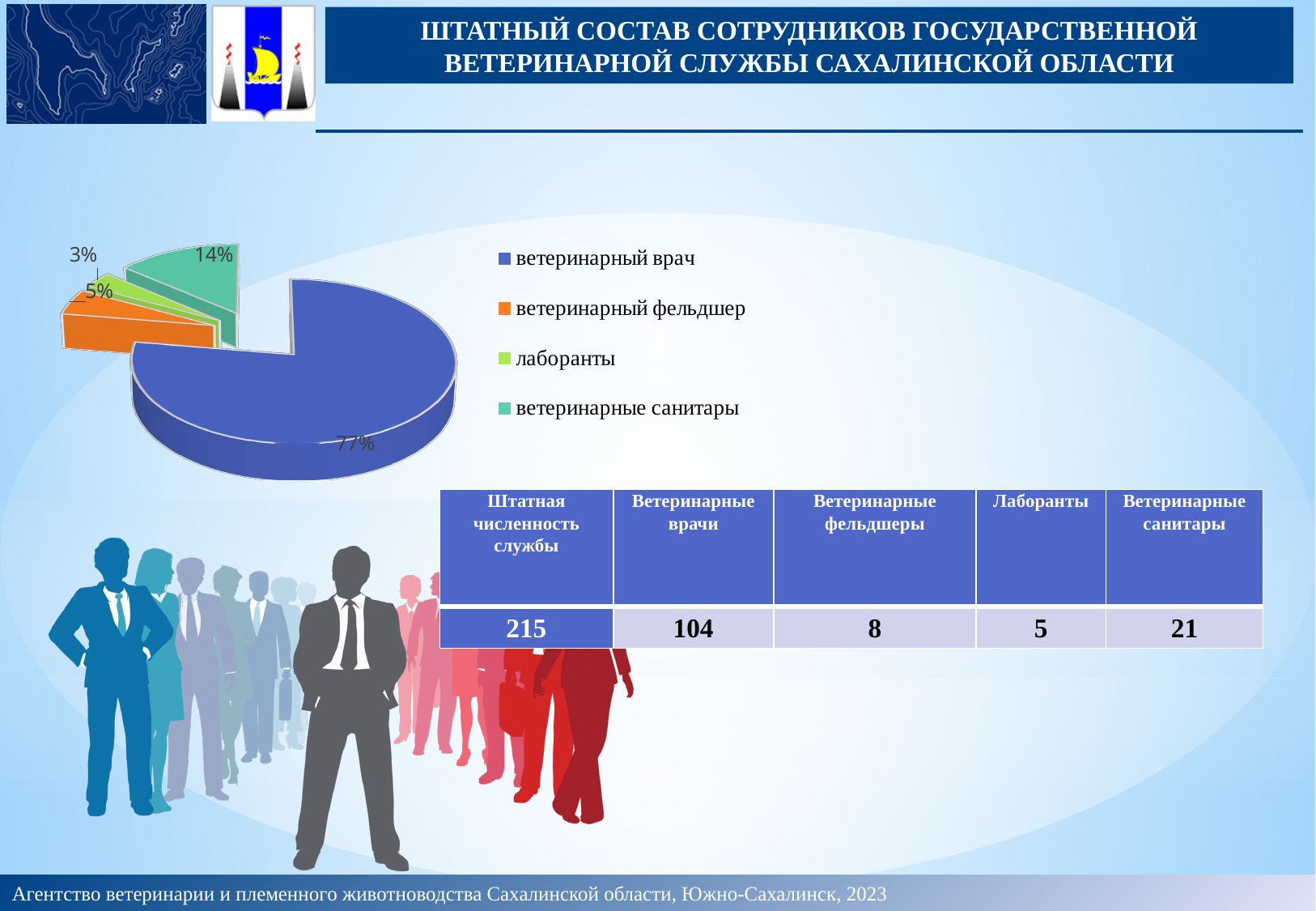
How many entries does the pie chart legend list? 4 How many categories does the pie chart show? 4 Which category has the smallest slice in the pie chart? лаборанты What share of the pie chart does ветеринарные санитары have? 14% What colour is the ветеринарный врач slice in the pie chart? blue What share of the pie chart does ветеринарный фельдшер have? 5% What share of the pie chart does лаборанты have? 3% Which category has the largest slice in the pie chart? ветеринарный врач What is the difference in percentage points between the ветеринарный врач slice and the ветеринарные санитары slice? 63 What share of the pie chart does ветеринарный врач have? 77% What kind of chart is shown on the slide? pie chart Which slice is larger: ветеринарный фельдшер or ветеринарные санитары? ветеринарные санитары